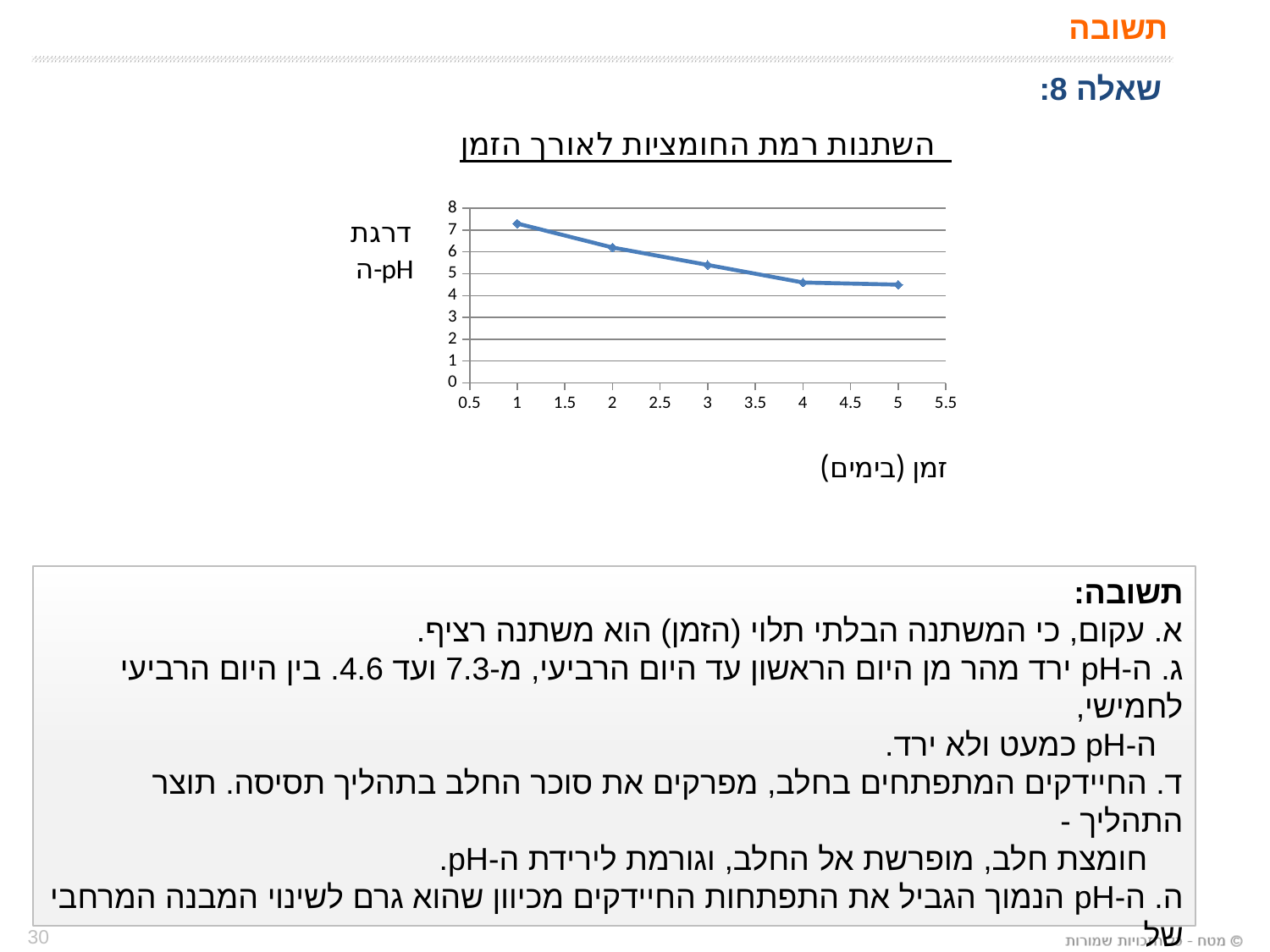
Is the pH value on day 4 greater or less than 5? less Is the pH value on day 3 greater or less than 6? less Do the pH values rise or fall as time (days) increases along the x axis? fall What kind of chart is shown on the slide? line chart Is the pH value on day 1 greater or less than 7? greater Which has the larger pH value, day 2 or day 5? day 2 On which day is the pH value highest? 1 What is the label of the x axis of the chart? זמן (בימים) How many data points are plotted on the line? 5 What is the title of the chart? השתנות רמת החומציות לאורך הזמן Which has the larger pH value, day 1 or day 3? day 1